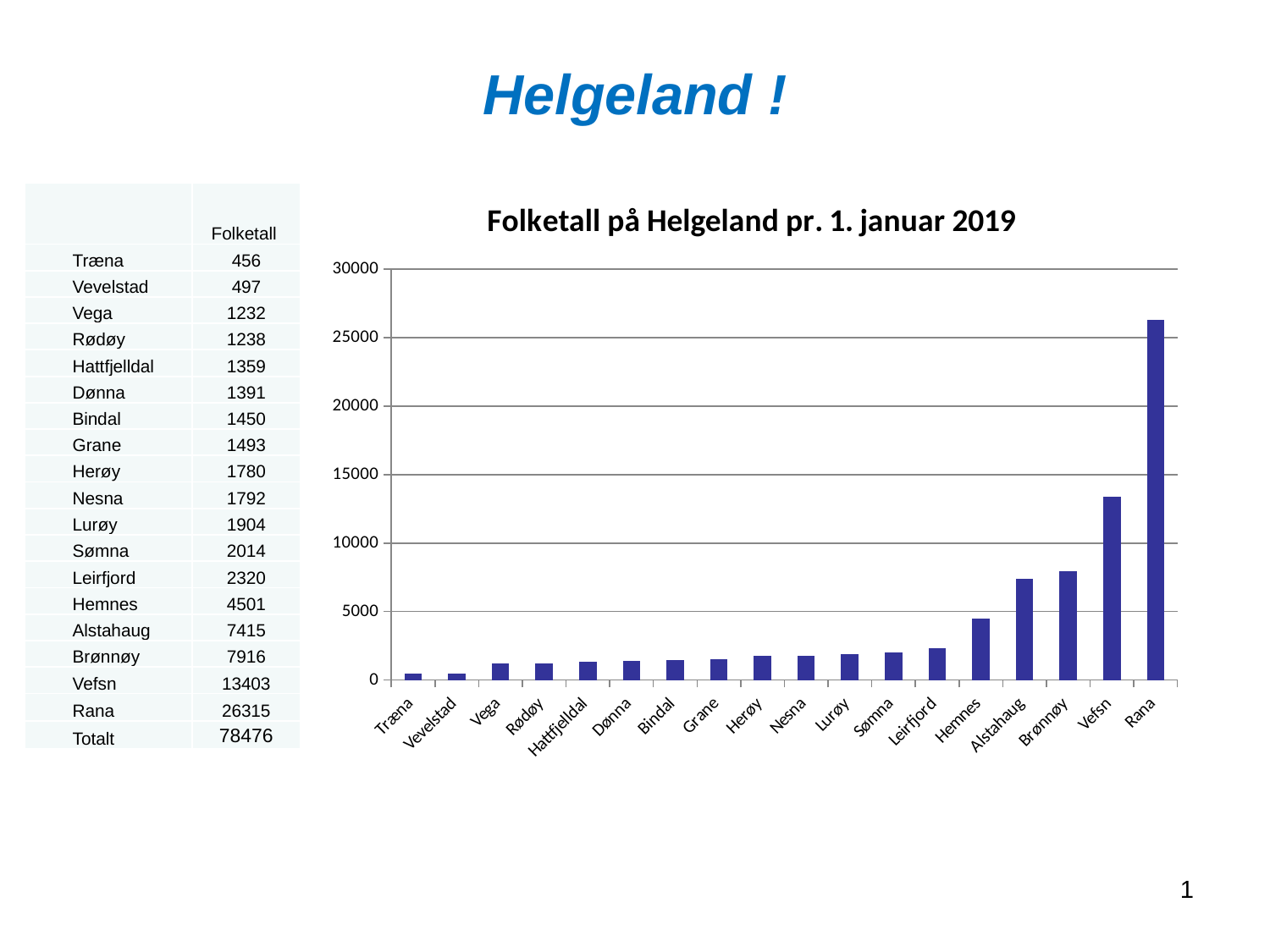
According to the slide, what is the population (Folketall) of Vefsn? 13403 How many municipalities are plotted on the x axis of the chart? 18 Which municipality has the highest population in the chart? Rana According to the slide, what is the population (Folketall) of Rana? 26315 What is the title of the chart? Folketall på Helgeland pr. 1. januar 2019 Which municipality has the lowest population in the chart? Træna Which is larger, the value for Brønnøy or the value for Alstahaug? Brønnøy Is the value for Alstahaug greater or less than 10000? less Is the value for Rana greater or less than 25000? greater What kind of chart is shown on the slide? bar chart According to the slide, what is the population (Folketall) of Hemnes? 4501 What is the difference between the populations of Rana and Vefsn as given on the slide? 12912